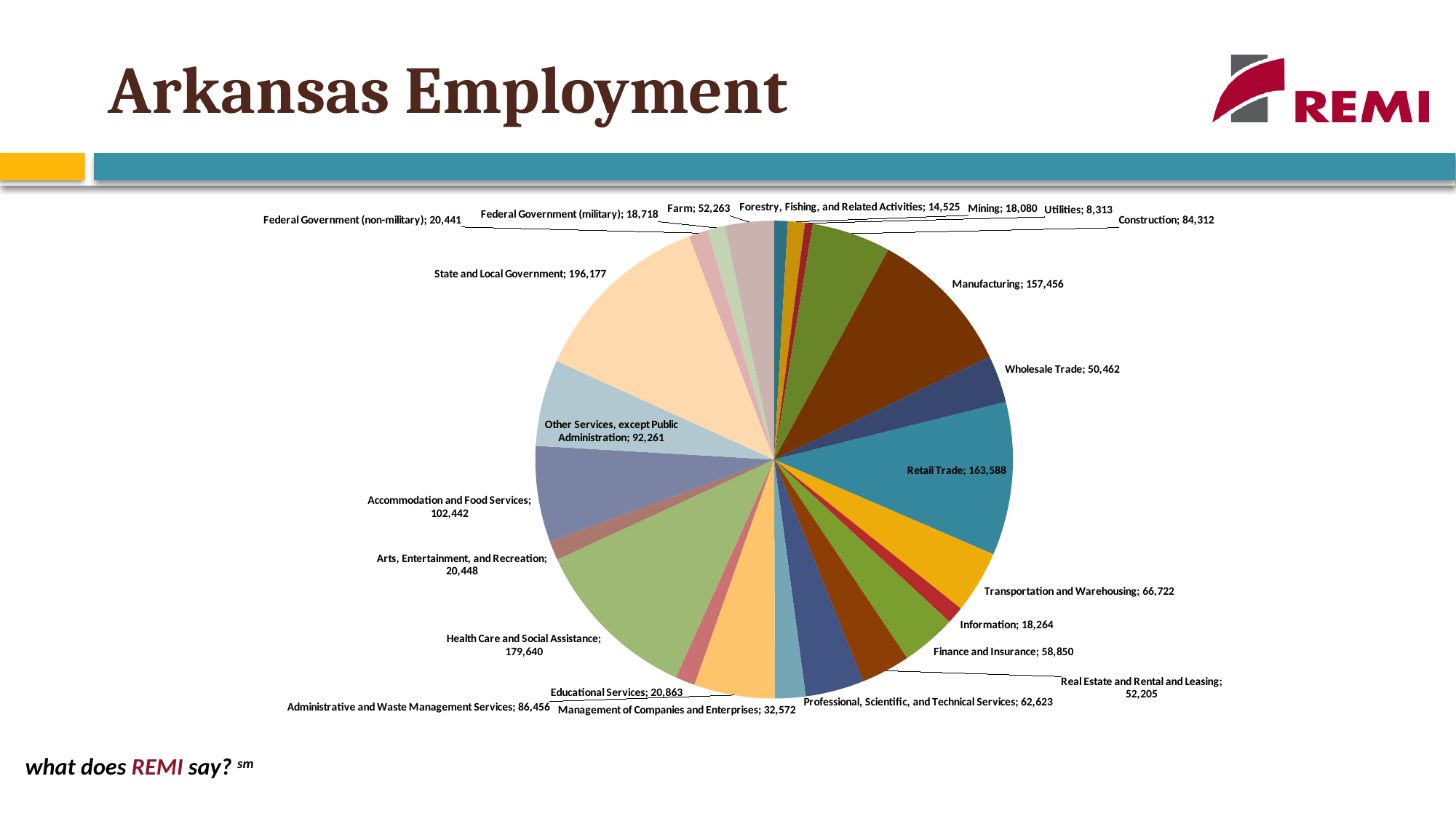
What is the difference between Health Care and Social Assistance and Accommodation and Food Services employment? 77,198 What is the title of the slide containing the chart? Arkansas Employment What is the employment value for Health Care and Social Assistance? 179,640 What is the employment value for Retail Trade? 163,588 What is the employment value for Management of Companies and Enterprises? 32,572 What is the employment value for Utilities? 8,313 Which category has the lowest employment? Utilities What is the difference between Retail Trade and Manufacturing employment? 6,132 Which is larger, Health Care and Social Assistance or Manufacturing? Health Care and Social Assistance Which category has the highest employment? State and Local Government How many categories are shown in the pie chart? 23 What type of chart is shown on the slide? Pie chart